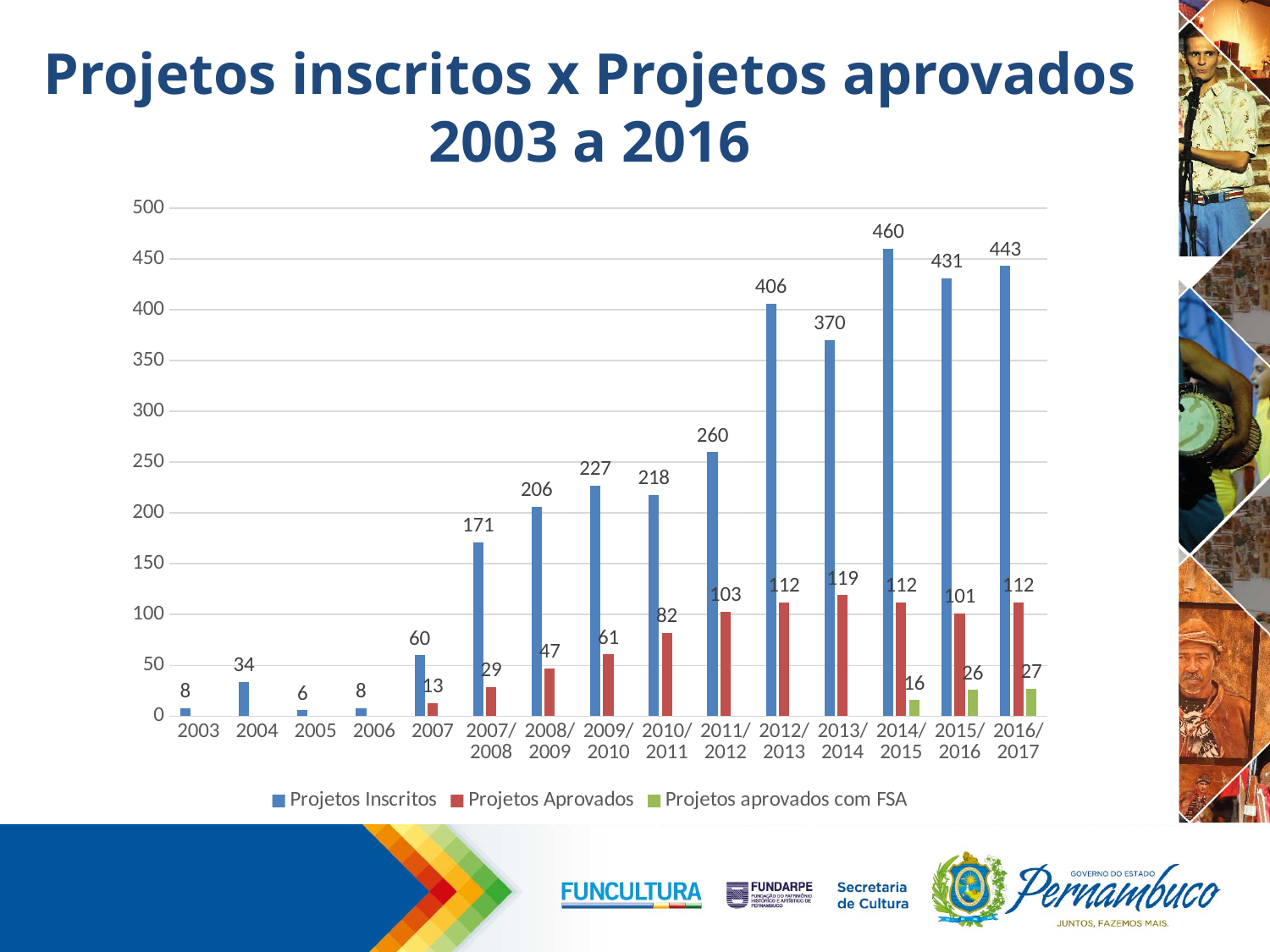
How many series does the legend list? 3 Which is larger, Projetos Inscritos in 2012/2013 or in 2013/2014? 2012/2013 What is the value of Projetos aprovados com FSA for 2016/2017? 27 What is the value of Projetos Aprovados for 2013/2014? 119 How many categories are shown on the x axis? 15 Which category has the lowest value for Projetos Inscritos? 2005 Which category has the highest value for Projetos Inscritos? 2014/2015 What is the title of the chart on the slide? Projetos inscritos x Projetos aprovados 2003 a 2016 What kind of chart is shown on the slide? Bar chart What is the value of Projetos Inscritos for 2014/2015? 460 Do the values for Projetos Aprovados rise or fall from 2007 to 2013/2014? Rise What is the difference between Projetos Inscritos and Projetos Aprovados in 2016/2017? 331